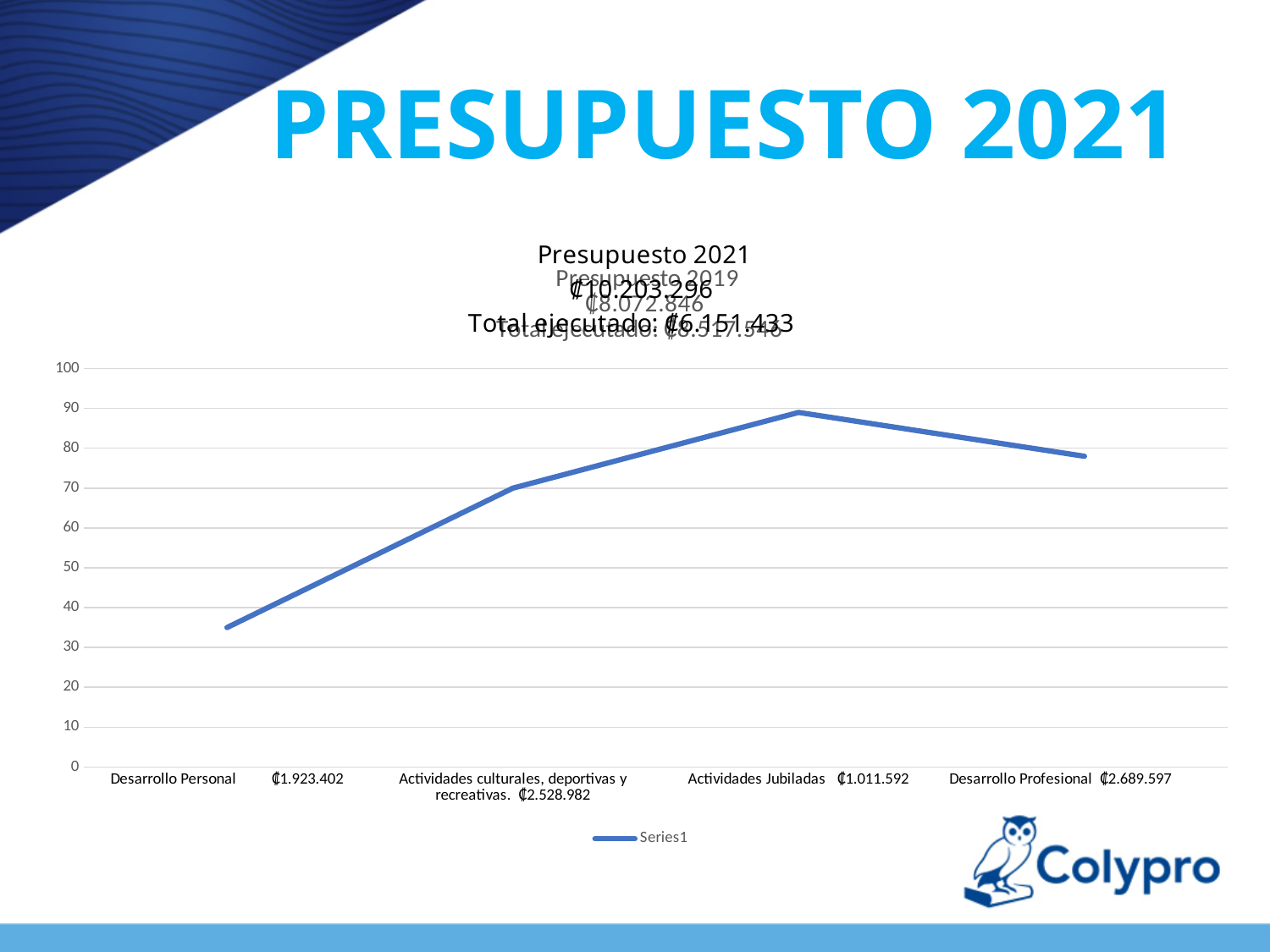
Is the value for Desarrollo Profesional greater or less than 70? greater Is the value for Actividades Jubiladas greater or less than 80? greater How many series does the chart legend list? 1 Which category has the highest value on the line? Actividades Jubiladas What is the name of the series shown in the chart legend? Series1 Is the value for Desarrollo Profesional greater or less than 80? less Does the line rise or fall between Actividades Jubiladas and Desarrollo Profesional? fall Which category has the lowest value on the line? Desarrollo Personal How many categories are plotted along the x axis of the chart? 4 What kind of chart is shown on the slide? line chart Which has the larger value, Desarrollo Personal or Desarrollo Profesional? Desarrollo Profesional